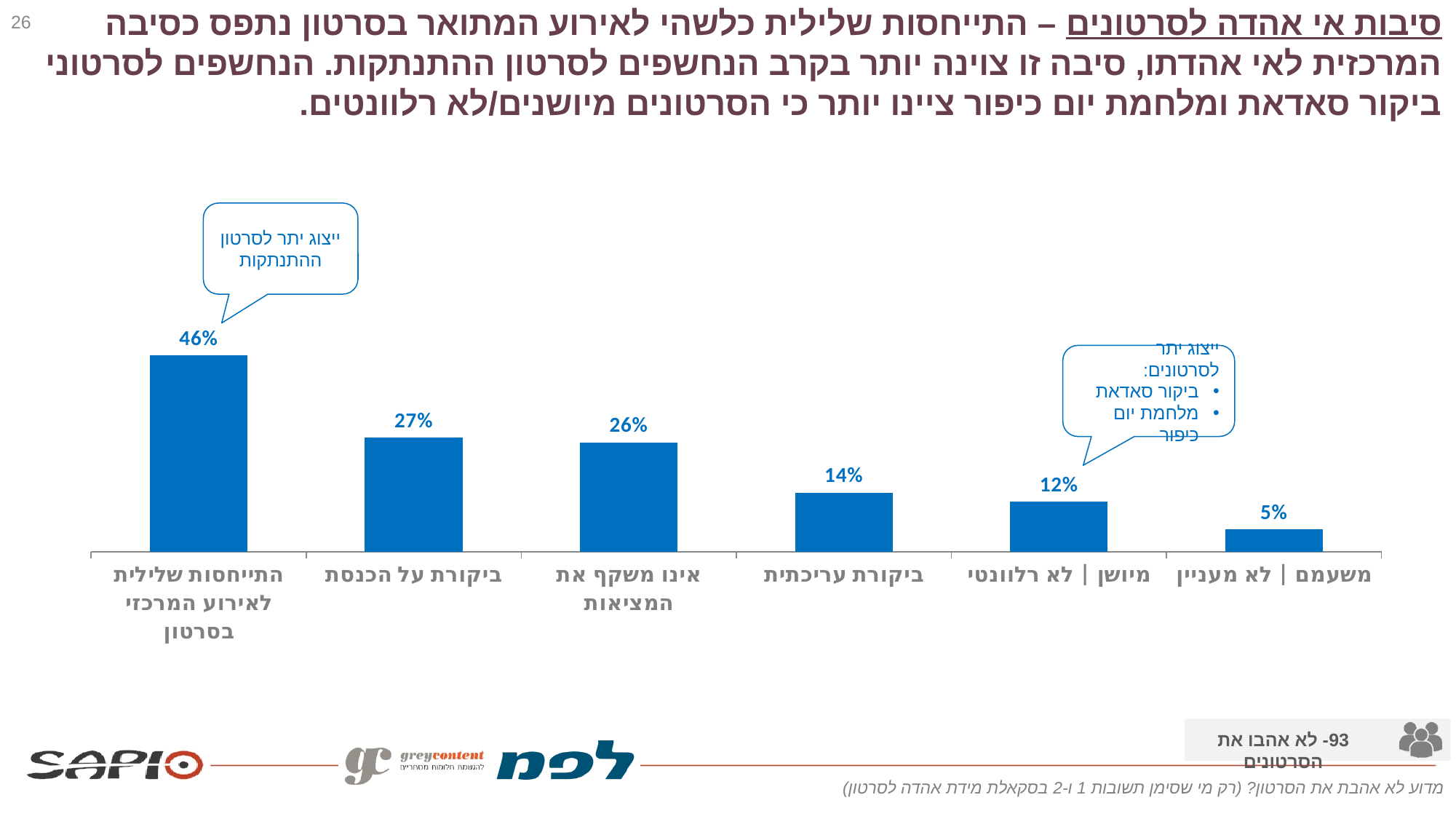
Which category has the highest value? התייחסות שלילית לאירוע המרכזי בסרטון What is the value for "אינו משקף את המציאות"? 26% Which is larger: the value for "ביקורת עריכתית" or the value for "משעמם | לא מעניין"? ביקורת עריכתית What is the difference between the values for "התייחסות שלילית לאירוע המרכזי בסרטון" and "ביקורת על הכנסת"? 19% How many categories (bars) does the chart show? 6 What is the difference between the values for "מיושן | לא רלוונטי" and "משעמם | לא מעניין"? 7% Which category has the lowest value? משעמם | לא מעניין What is the value for "מיושן | לא רלוונטי"? 12% What is the value for "ביקורת על הכנסת"? 27% What kind of chart is shown on the slide? bar chart What is the value for "ביקורת עריכתית"? 14% What is the value for "התייחסות שלילית לאירוע המרכזי בסרטון"? 46%